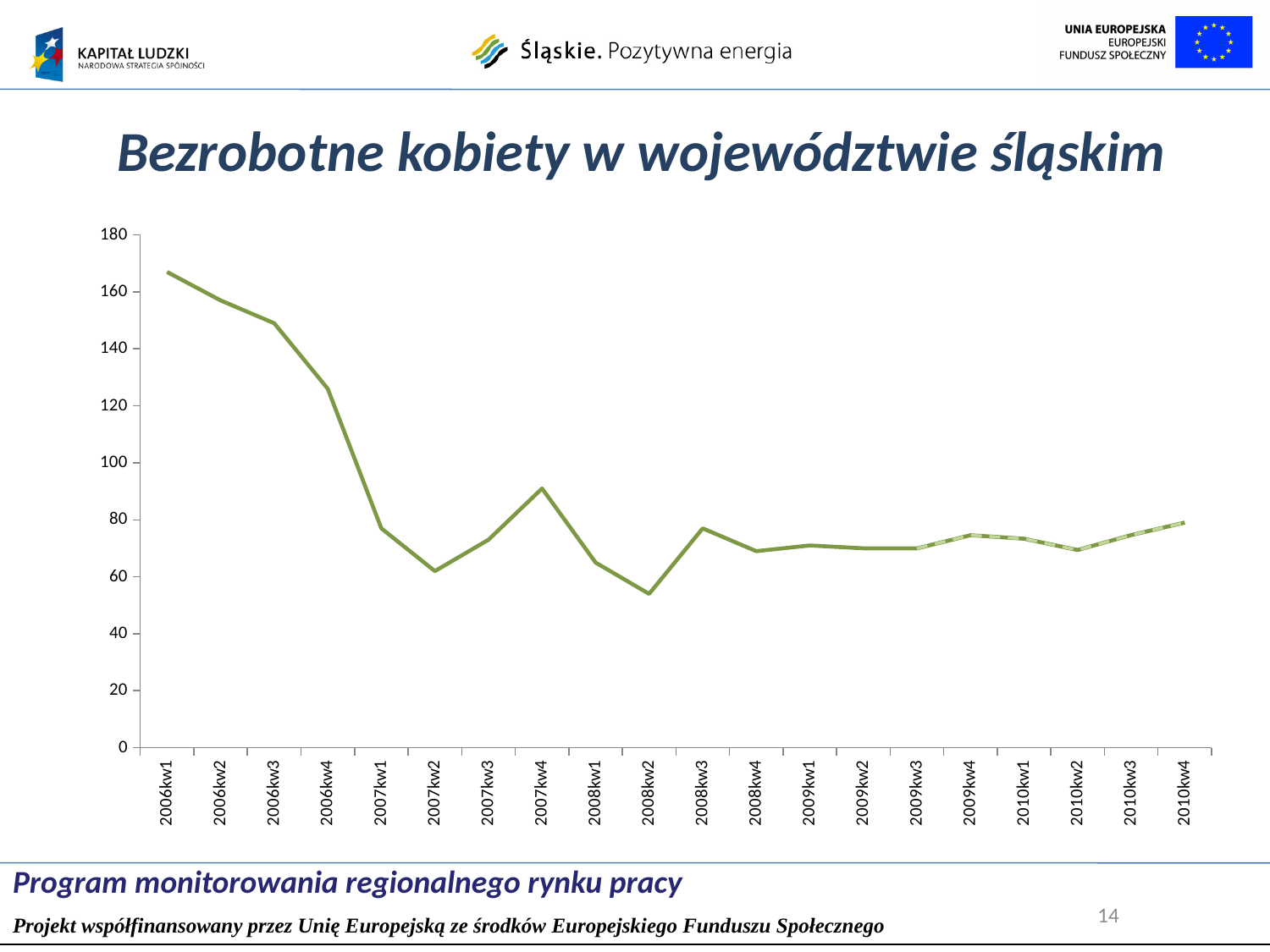
Do the values rise or fall from 2006kw1 to 2007kw2? fall Which is larger, the value for 2006kw1 or the value for 2010kw4? 2006kw1 Which is larger, the value for 2007kw4 or the value for 2008kw1? 2007kw4 Is the value for 2006kw4 greater or less than 120? greater How many quarters (points) are plotted along the x axis? 20 What kind of chart is shown on the slide? line chart Which quarter has the lowest value? 2008kw2 Is the value for 2007kw4 greater or less than 80? greater Which quarter has the highest value? 2006kw1 Is the value for 2006kw1 greater or less than 160? greater What is the title of the chart? Bezrobotne kobiety w województwie śląskim